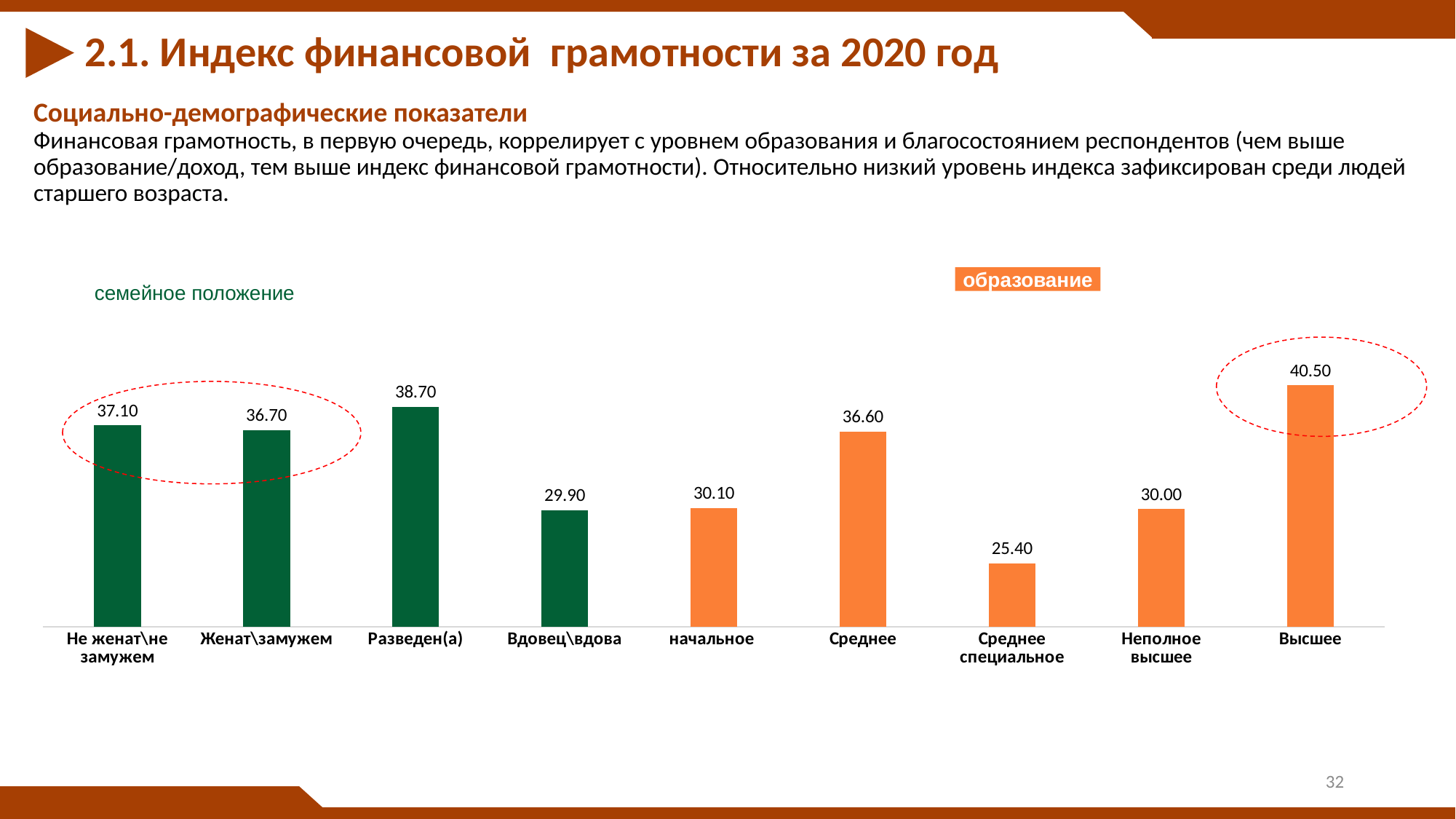
Which category has the highest value on the chart? Высшее Which has a larger value: "Разведен(а)" or "Вдовец\вдова"? Разведен(а) Which group of bars is shown in orange? образование What is the financial literacy index value for the category "Разведен(а)"? 38.70 What is the difference between the values for "Не женат\не замужем" and "Женат\замужем"? 0.40 What is the value shown for "Среднее специальное"? 25.40 What is the difference between the values for "Высшее" and "Среднее специальное"? 15.10 What type of chart is shown on the slide? Bar chart Which category has the lowest value on the chart? Среднее специальное What is the value shown for "Вдовец\вдова"? 29.90 What is the value shown for "Высшее" education? 40.50 How many categories are plotted on the chart? 9